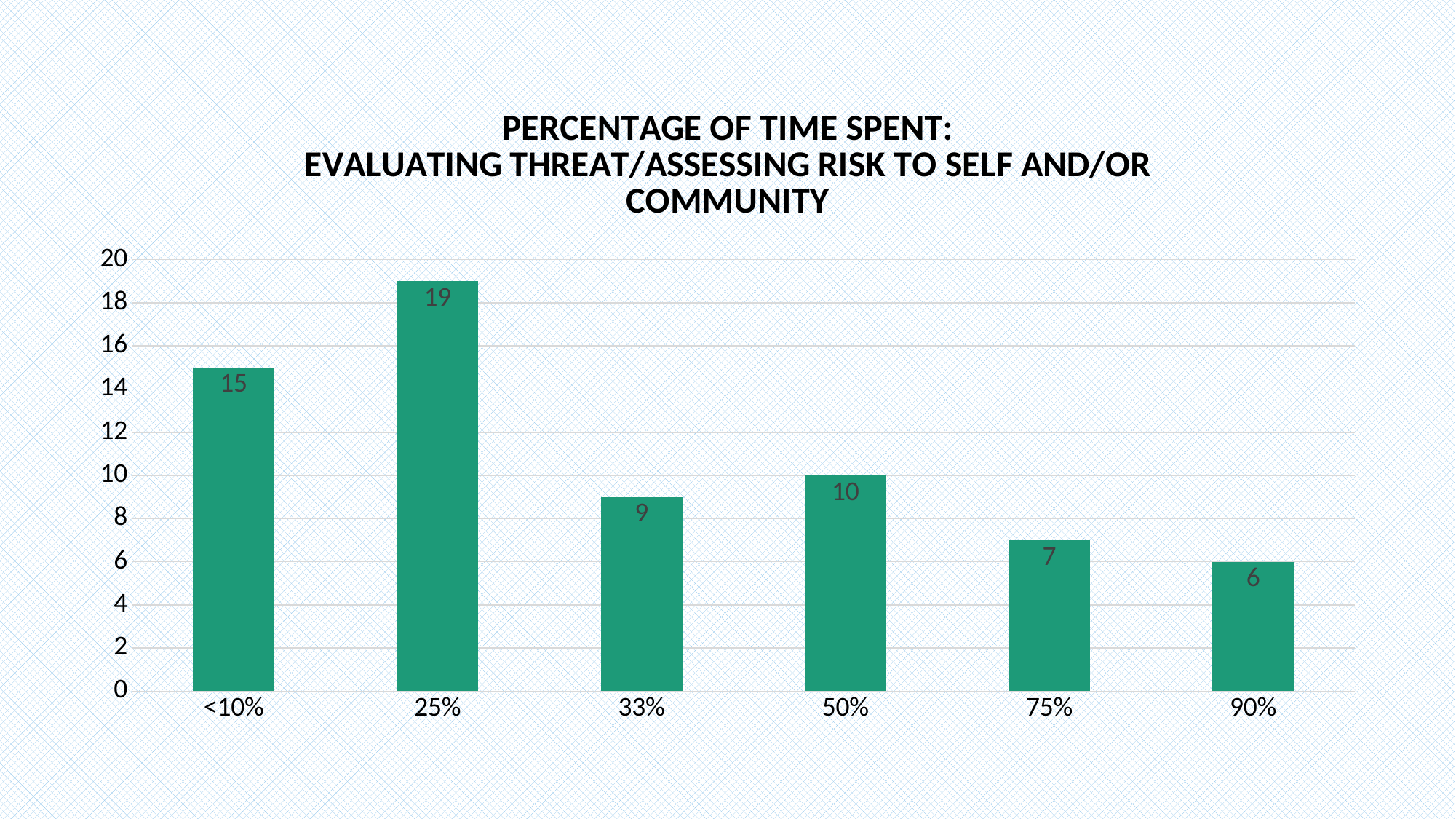
How many categories are shown on the x axis? 6 Is the value for 75% greater or less than 10? less Which category has the lowest value? 90% Which is larger, the value for 33% or the value for 50%? 50% What kind of chart is shown on the slide? bar chart What is the value for the 90% category? 6 What is the difference between the values for 25% and <10%? 4 Which category has the highest value? 25% What is the difference between the values for 50% and 75%? 3 What is the title of the chart? Percentage of Time Spent: Evaluating Threat/Assessing Risk to Self and/or Community What is the value for the 25% category? 19 What is the value for the <10% category? 15